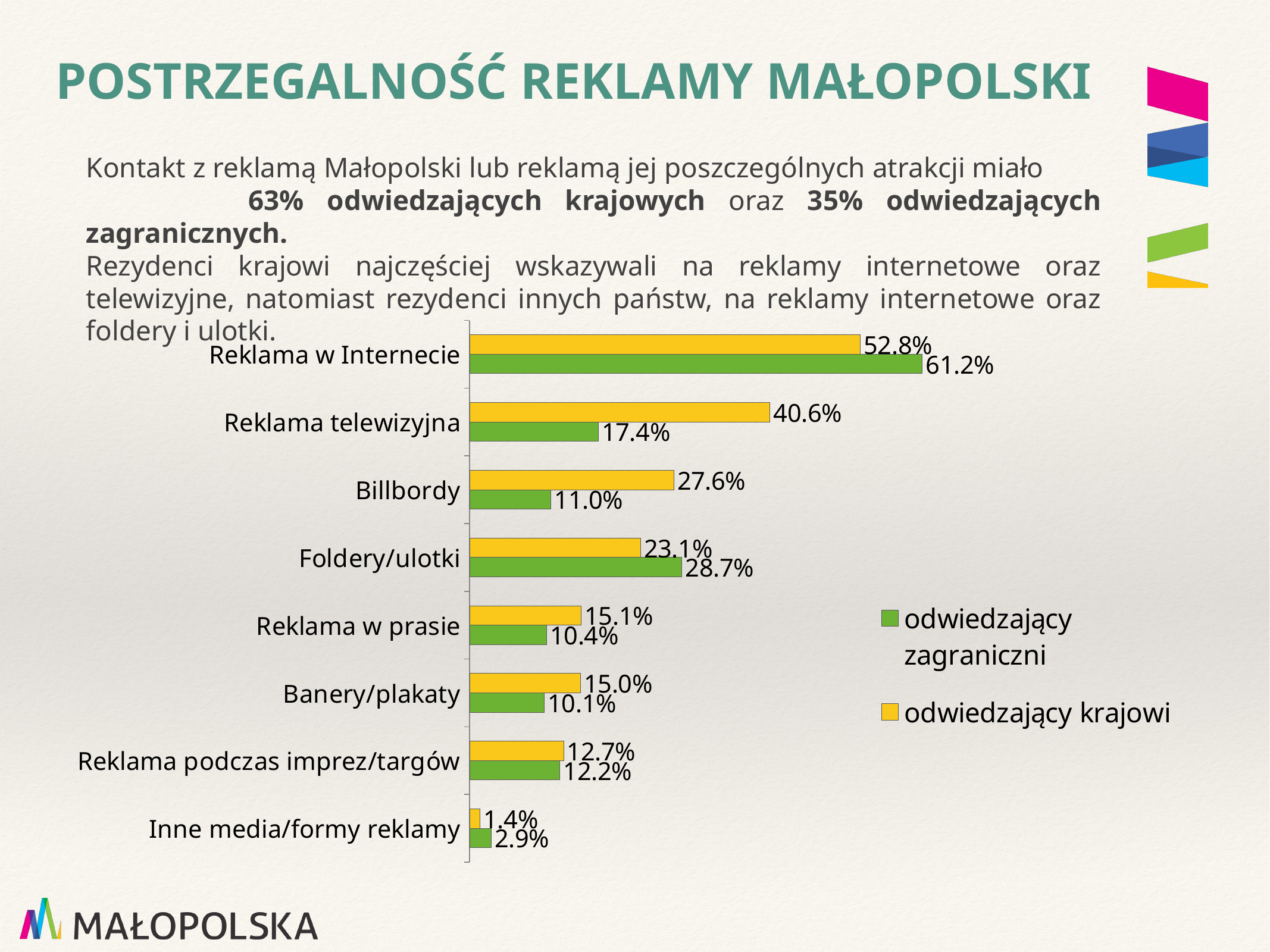
What is the value for Reklama podczas imprez/targów for the odwiedzający zagraniczni series? 12.2% Which category has the highest value for the odwiedzający zagraniczni series? Reklama w Internecie Which category has the lowest value for the odwiedzający krajowi series? Inne media/formy reklamy How many categories are shown on the chart? 8 For Foldery/ulotki, which series has the larger value: odwiedzający krajowi or odwiedzający zagraniczni? odwiedzający zagraniczni How many series does the legend list? 2 What is the value for Billbordy for the odwiedzający krajowi series? 27.6% What is the value for Reklama telewizyjna for the odwiedzający zagraniczni series? 17.4% What colour represents the odwiedzający krajowi series? yellow What kind of chart is shown on the slide? bar chart What is the difference between the odwiedzający krajowi and odwiedzający zagraniczni values for Reklama telewizyjna? 23.2% What is the value for Reklama w Internecie for the odwiedzający krajowi series? 52.8%